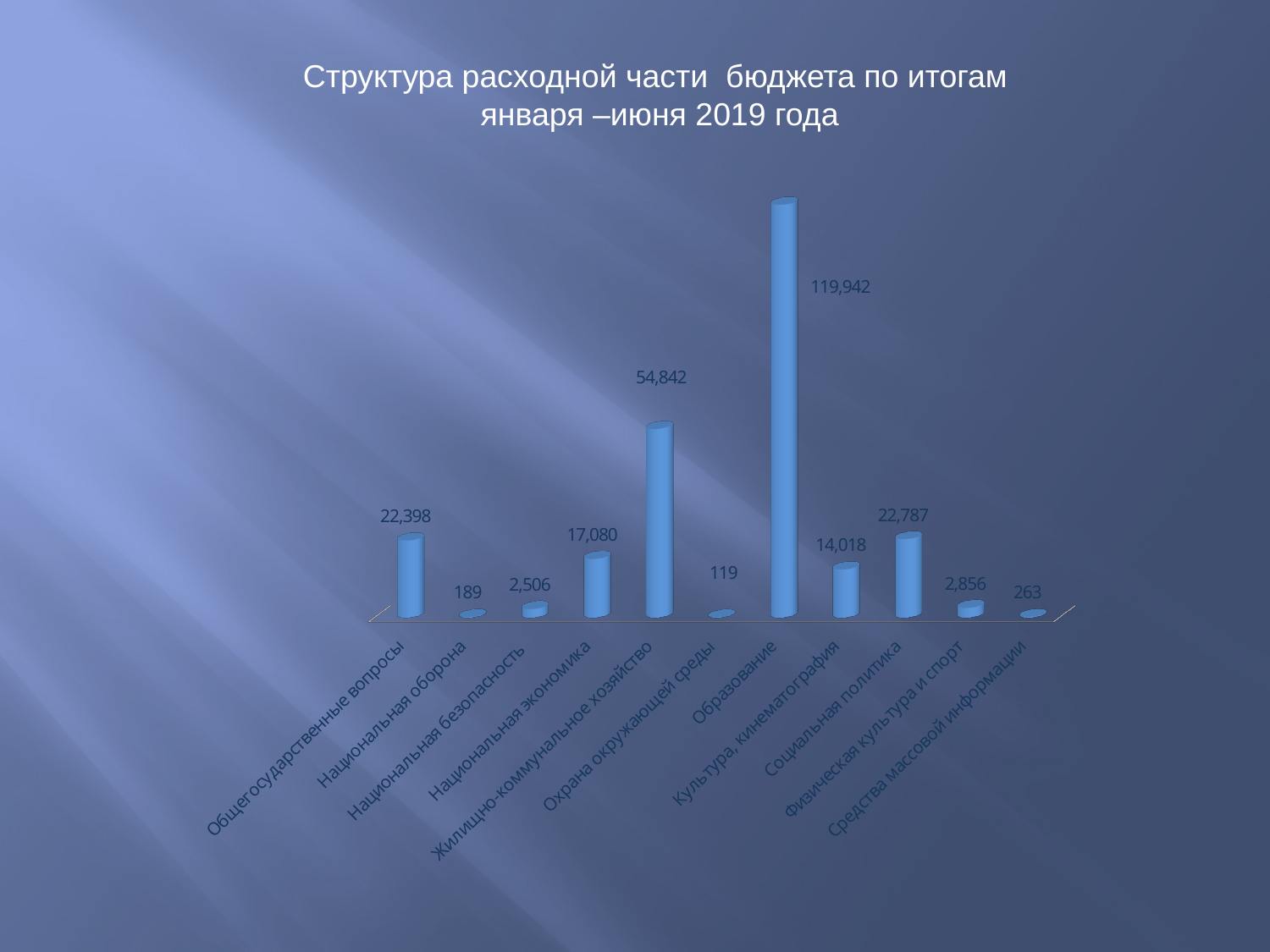
Which category has the lowest value? Охрана окружающей среды What is the value for Социальная политика? 22,787 What is the difference between the values for Образование and Жилищно-коммунальное хозяйство? 65,100 What is the value for Образование? 119,942 How many categories are shown in the chart? 11 What is the value for Культура, кинематография? 14,018 Which category has the highest value? Образование What kind of chart is shown on the slide? Bar chart Which is larger, the value for Национальная экономика or the value for Культура, кинематография? Национальная экономика What is the title of the slide? Структура расходной части бюджета по итогам января –июня 2019 года What is the value for Жилищно-коммунальное хозяйство? 54,842 What is the value for Национальная оборона? 189